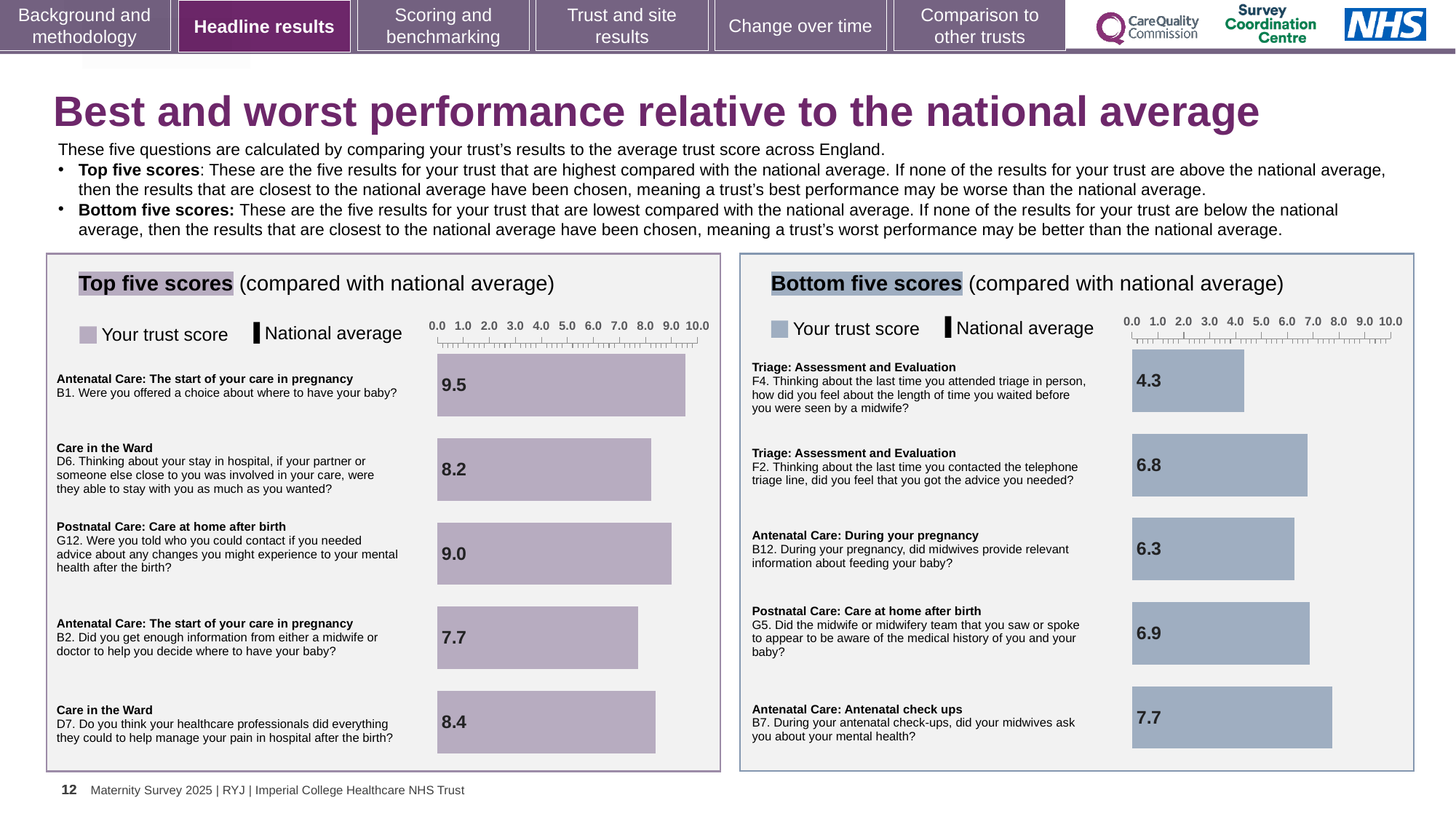
On the Bottom five scores chart, what is the difference between the trust scores for B7 and F4? 3.4 On the Bottom five scores chart, which has the larger trust score: F2 or G5? G5 How many questions are plotted on the Top five scores chart? 5 On the Bottom five scores chart, which question has the highest trust score? B7 (Antenatal Care: Antenatal check ups) On the Top five scores chart, what is the trust score for B1 (Were you offered a choice about where to have your baby)? 9.5 On the Top five scores chart, what is the trust score for D7 (healthcare professionals did everything they could to help manage your pain)? 8.4 On the Top five scores chart, which question has the highest trust score? B1 (Antenatal Care: The start of your care in pregnancy) On the Bottom five scores chart, what is the trust score for F4 (length of time you waited before you were seen by a midwife at triage)? 4.3 On the Bottom five scores chart, which question has the lowest trust score? F4 (Triage: Assessment and Evaluation) On the Top five scores chart, which question has the lowest trust score? B2 (Antenatal Care: The start of your care in pregnancy) What kind of chart is the Bottom five scores chart? Bar chart On the Top five scores chart, what is the difference between the trust scores for B1 and B2? 1.8